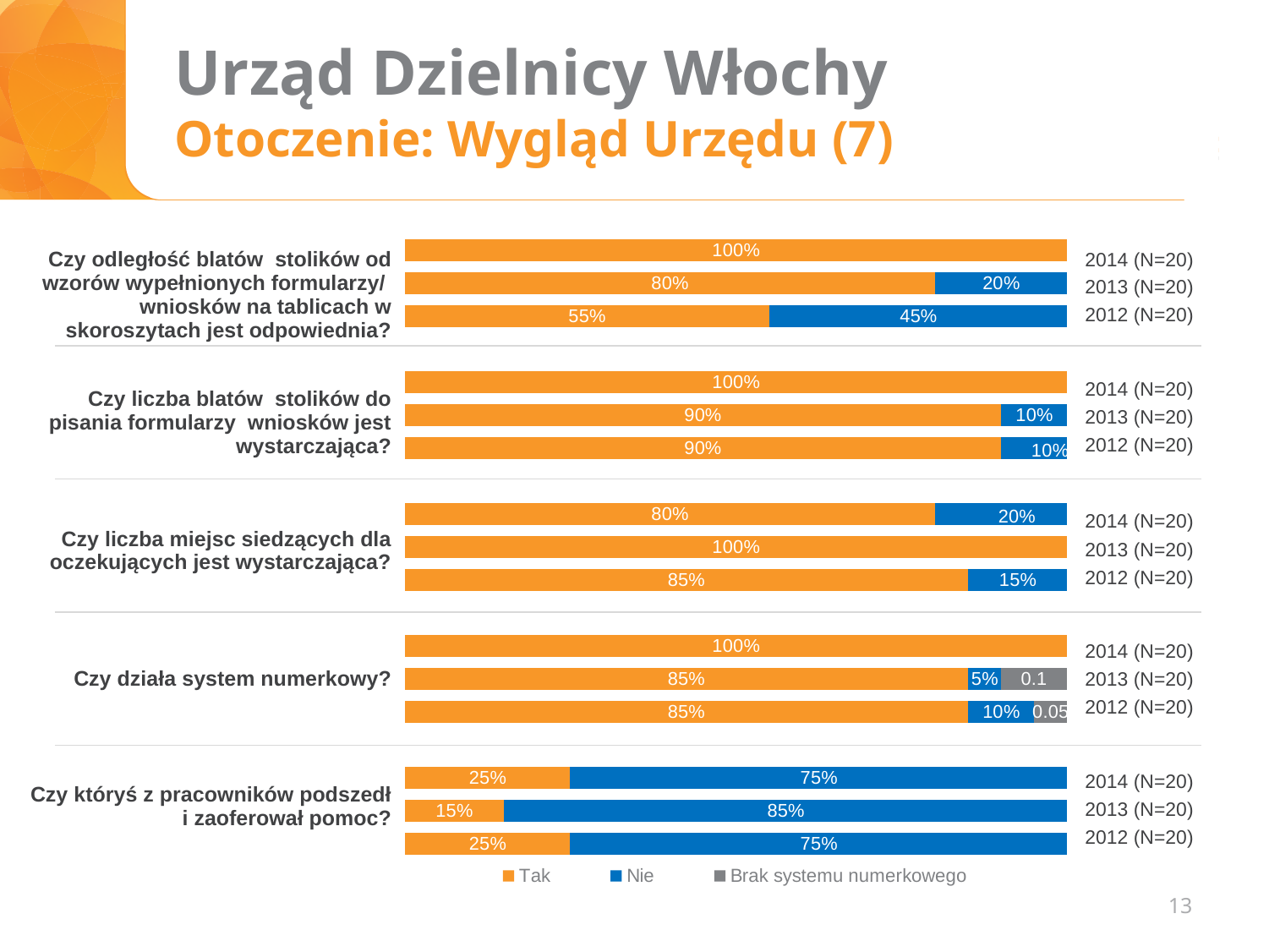
What type of chart is used for "Czy odległość blatów stolików od wzorów wypełnionych formularzy/wniosków na tablicach w skoroszytach jest odpowiednia?"? Stacked bar chart In the chart for "Czy któryś z pracowników podszedł i zaoferował pomoc?", which year has the lowest Tak value? 2013 (N=20) In the chart for "Czy odległość blatów stolików od wzorów wypełnionych formularzy/wniosków na tablicach w skoroszytach jest odpowiednia?", what is the Nie value for 2013 (N=20)? 20% In the chart for "Czy liczba miejsc siedzących dla oczekujących jest wystarczająca?", what is the difference between the Tak values for 2012 (N=20) and 2014 (N=20)? 5% In the chart for "Czy liczba miejsc siedzących dla oczekujących jest wystarczająca?", which year has the highest Tak value? 2013 (N=20) In the chart for "Czy liczba blatów stolików do pisania formularzy wniosków jest wystarczająca?", what is the Tak value for 2013 (N=20)? 90% In the chart for "Czy któryś z pracowników podszedł i zaoferował pomoc?", is the Nie value for 2014 (N=20) larger or smaller than the Nie value for 2013 (N=20)? smaller How many series does the legend at the bottom of the slide list? 3 How many bars does the chart for "Czy działa system numerkowy?" contain? 3 In the chart for "Czy działa system numerkowy?", what is the Brak systemu numerkowego value for 2013 (N=20)? 0.1 In the chart for "Czy odległość blatów stolików od wzorów wypełnionych formularzy/wniosków na tablicach w skoroszytach jest odpowiednia?", what is the Tak value for 2012 (N=20)? 55% In the chart for "Czy działa system numerkowy?", what is the Nie value for 2012 (N=20)? 10%